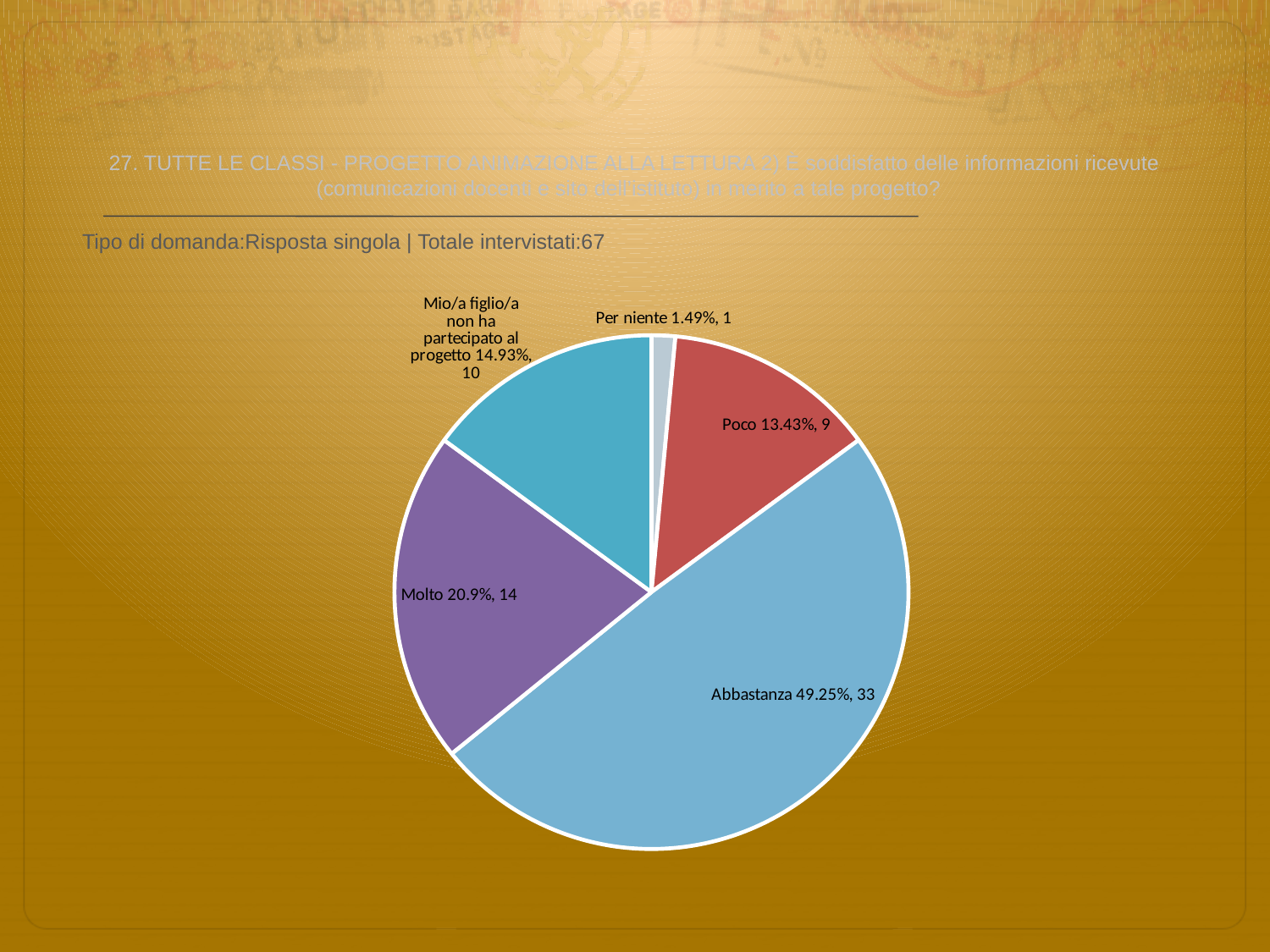
How many respondents answered 'Mio/a figlio/a non ha partecipato al progetto'? 10 Which category has the smallest slice of the pie? Per niente What percentage share does the 'Per niente' slice have? 1.49% Which is larger, the 'Molto' slice or the 'Poco' slice? Molto How many respondents answered 'Molto'? 14 What kind of chart is shown on the slide? pie chart What is the total number of interviewees stated on the slide? 67 How many respondents answered 'Poco'? 9 What is the difference in count between 'Abbastanza' and 'Molto'? 19 Which category has the largest slice of the pie? Abbastanza What percentage share does the 'Abbastanza' slice have? 49.25% How many slices does the pie chart have? 5